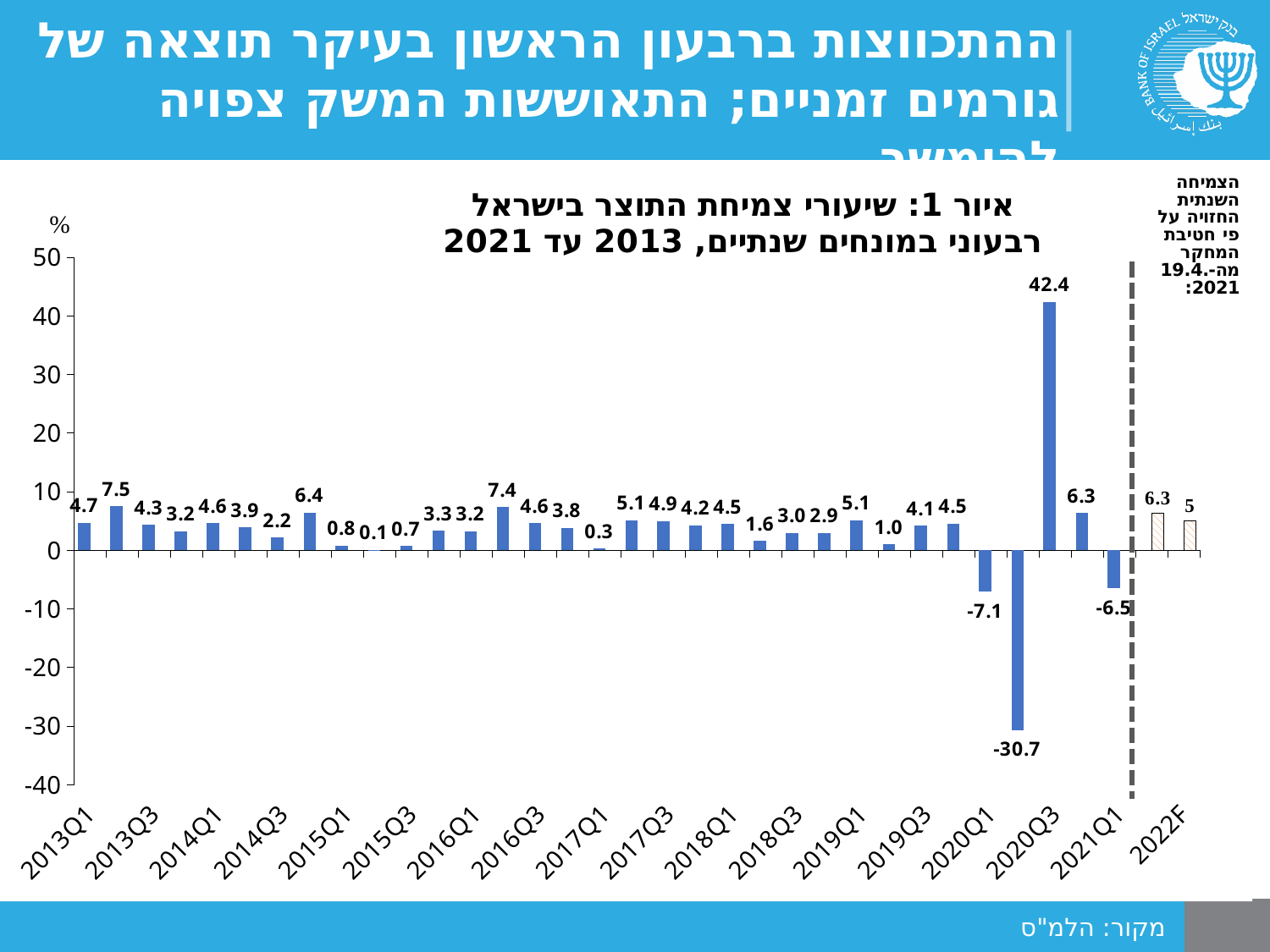
What is the value for 2022F? 5 What is the difference between the values for 2020Q3 and 2021Q1? 48.9 What is the source cited at the bottom of the slide? הלמ"ס What is the value for 2013Q1? 4.7 What is the lowest value shown in the chart? -30.7 Which quarter has the highest value in the chart? 2020Q3 What kind of chart is shown on the slide? bar chart What is the value for 2021Q1? -6.5 Is the value for 2020Q3 greater or less than 40? greater What is the value for 2020Q3? 42.4 Which is larger, the value for 2013Q1 or the value for 2013Q3? 2013Q1 What unit is shown at the top of the vertical axis? %